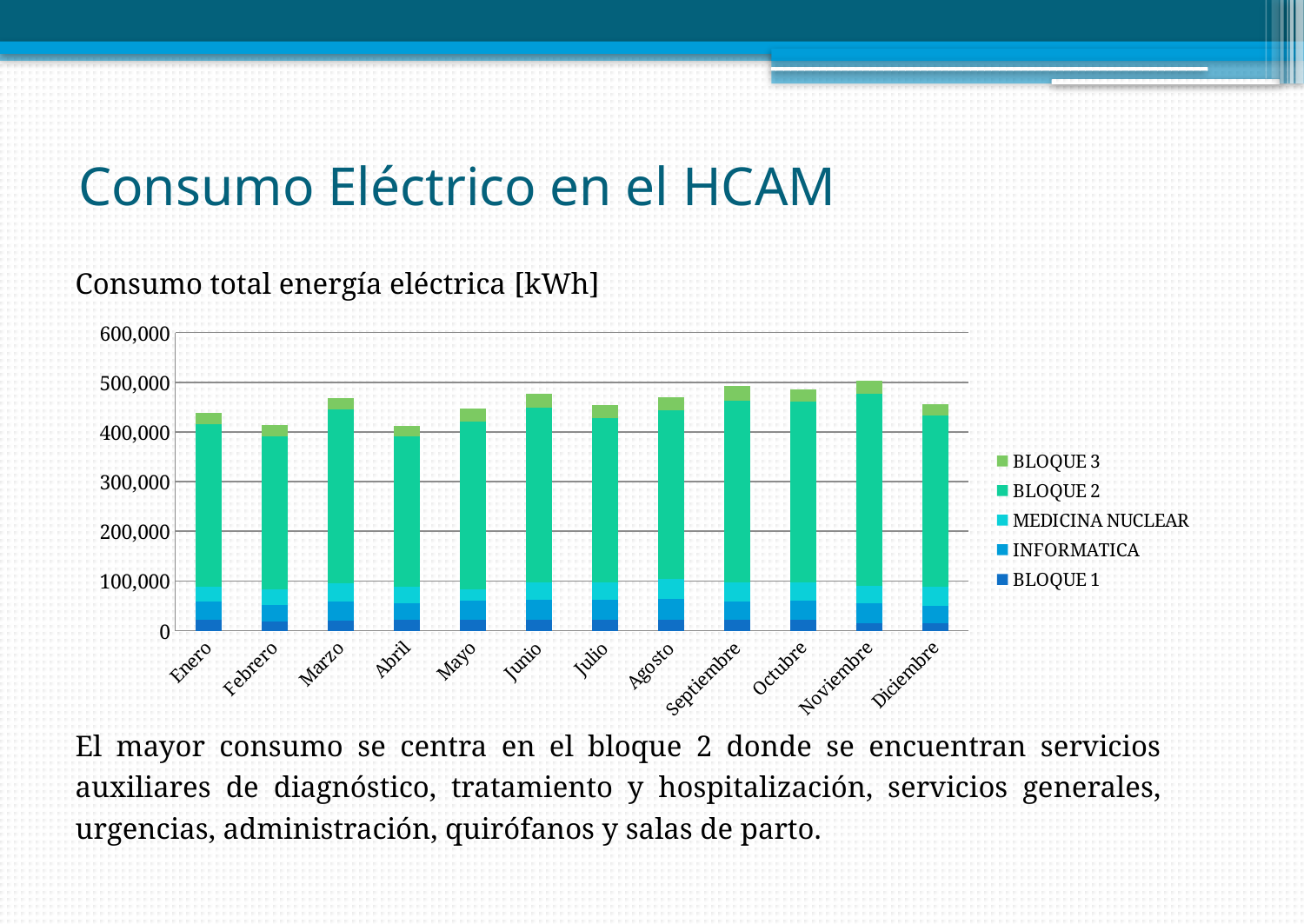
Which series accounts for the largest portion of each bar? BLOQUE 2 How many months are shown on the x axis of the chart? 12 Which month has a larger total consumption, Septiembre or Abril? Septiembre What is the title of the chart? Consumo total energía eléctrica [kWh] Is the total consumption for Marzo greater or less than 400,000? greater What kind of chart is shown on the slide? Stacked bar chart Which month has a larger total consumption, Noviembre or Febrero? Noviembre Which series is shown at the bottom of each stacked bar? BLOQUE 1 How many series does the chart legend list? 5 Which month has the highest total electricity consumption? Noviembre Is the total consumption for Enero greater or less than 500,000? less Is the total consumption for Febrero greater or less than 500,000? less